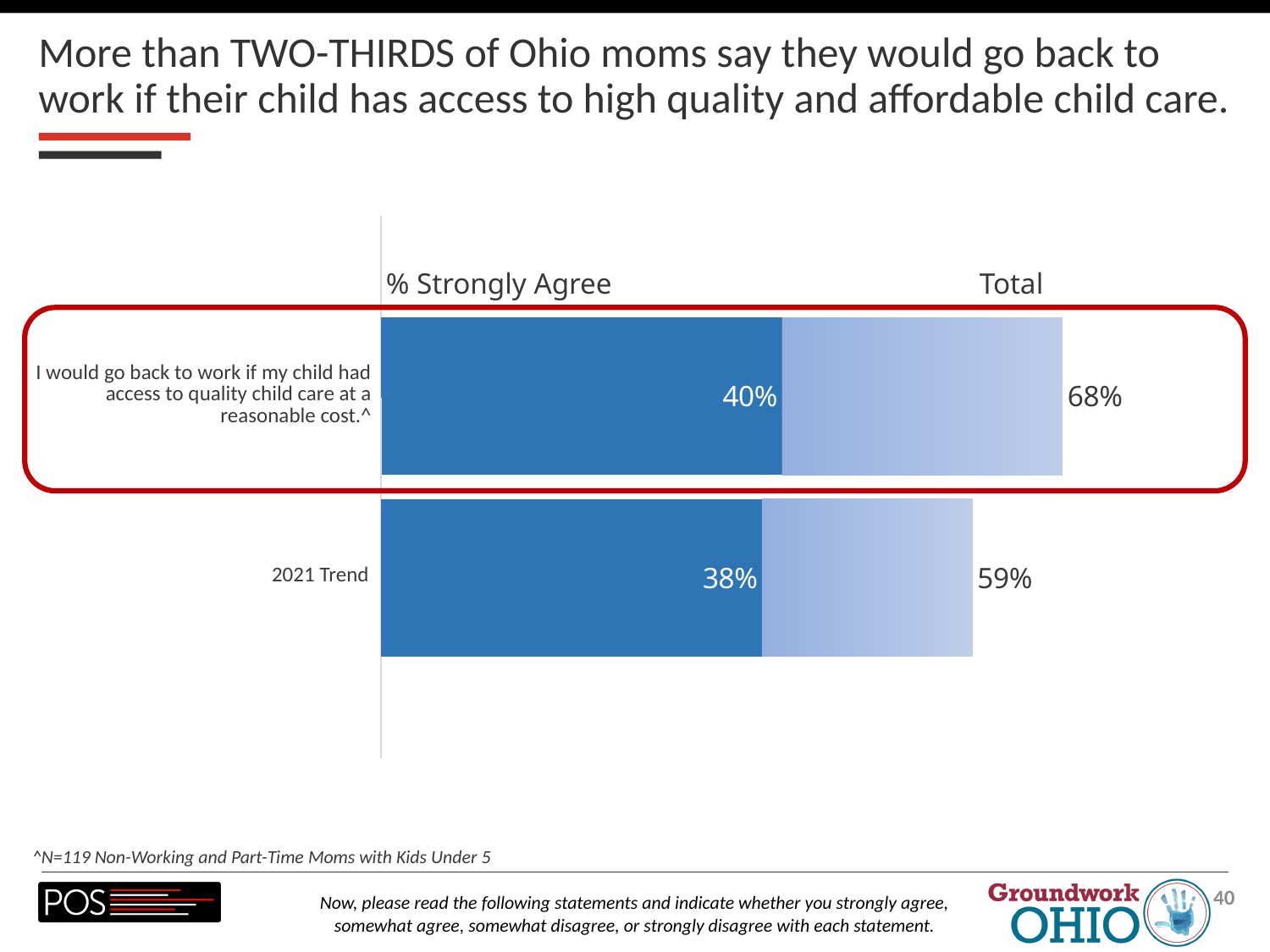
What is the Total value for the 2021 Trend bar? 59% Which bar has the lowest % Strongly Agree value? 2021 Trend By how many percentage points does the Total for the current statement exceed the 2021 Trend Total? 9 percentage points What type of chart is shown on the slide? Stacked horizontal bar chart What percentage of Ohio moms strongly agree that they would go back to work if their child had access to quality child care at a reasonable cost? 40% Which bar on the chart is outlined with a red box? I would go back to work if my child had access to quality child care at a reasonable cost.^ How many bars (categories) are plotted in the chart? 2 What are the two column headings shown above the chart? % Strongly Agree and Total What is the Total value shown for the statement "I would go back to work if my child had access to quality child care at a reasonable cost"? 68% Which bar has the higher Total value, the current statement or the 2021 Trend? The current statement (68%) By how many percentage points does the % Strongly Agree for the current statement exceed the 2021 Trend % Strongly Agree? 2 percentage points What is the % Strongly Agree value for the 2021 Trend bar? 38%